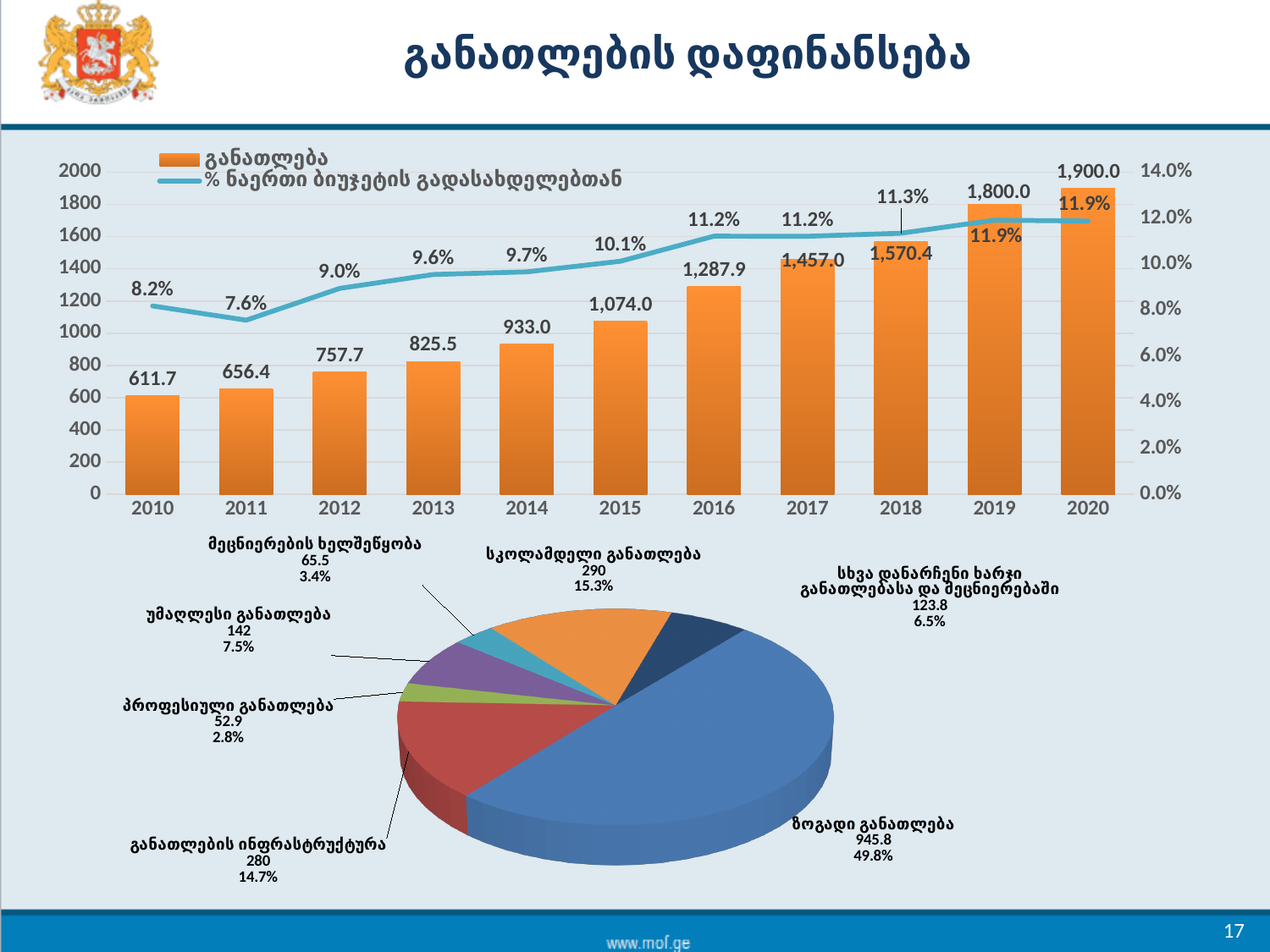
In the bottom pie chart, which slice is the smallest? პროფესიული განათლება In the top chart, how many series does the legend list? 2 In the top chart, which is larger, the განათლება value for 2014 or for 2015? 2015 In the top chart, what is the value of the % ნაერთი ბიუჯეტის გადასახდელებთან line for 2013? 9.6% In the bottom pie chart, what share does ზოგადი განათლება have? 49.8% In the top chart, do the განათლება bar values rise or fall from 2010 to 2020? rise In the top chart, what is the value of the განათლება bar for 2016? 1,287.9 In the bottom pie chart, what is the value for სკოლამდელი განათლება? 290 In the top chart, what is the difference between the განათლება values for 2020 and 2019? 100.0 In the top chart, which year has the lowest value on the % ნაერთი ბიუჯეტის გადასახდელებთან line? 2011 In the top chart, how many years are shown on the x axis? 11 In the top chart, which year has the highest განათლება bar? 2020